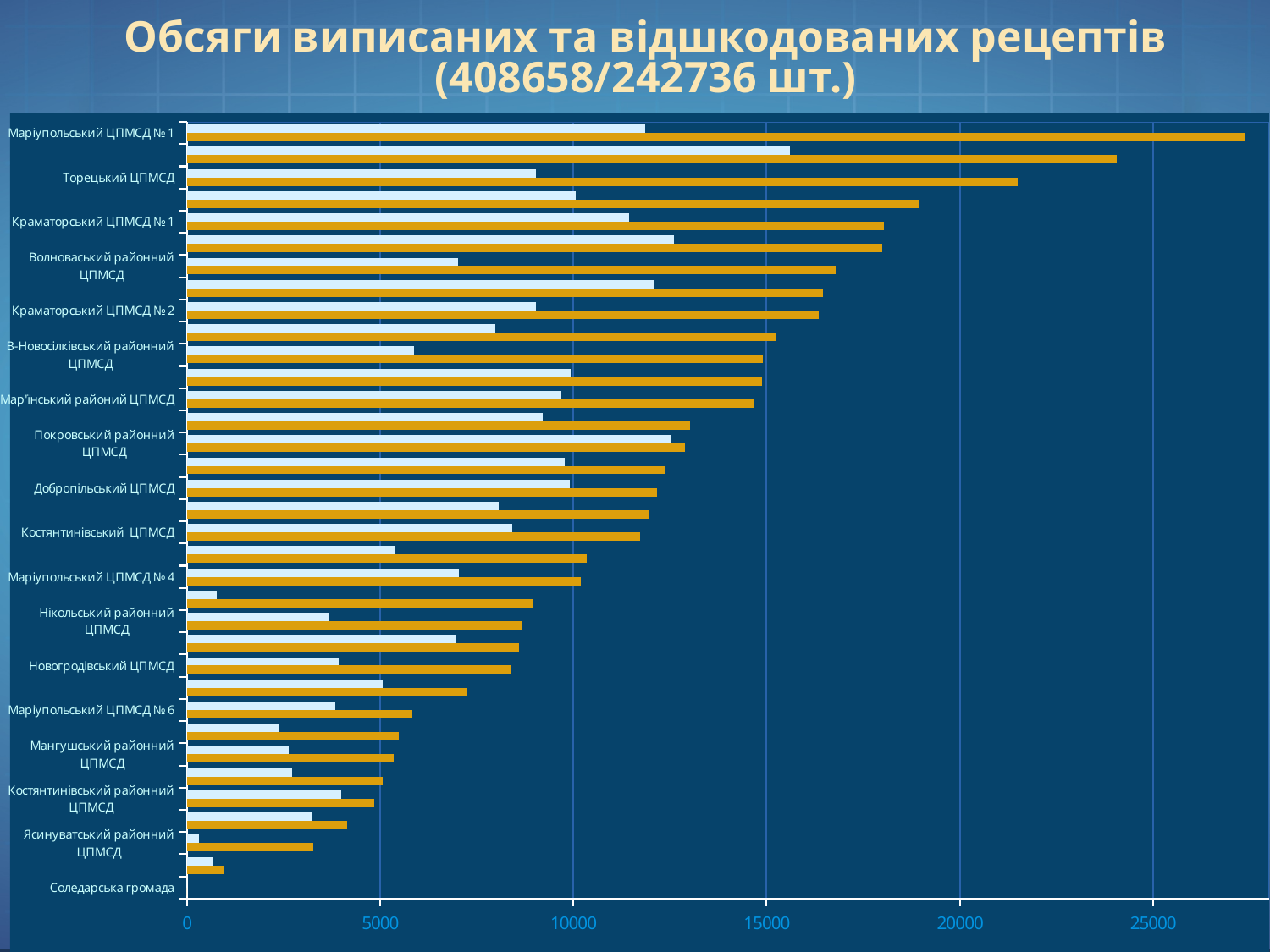
Which has the longer orange bar, Краматорський ЦПМСД № 1 or Маріупольський ЦПМСД № 6? Краматорський ЦПМСД № 1 Is the orange bar for Маріупольський ЦПМСД № 1 greater or less than 25000? greater Is the orange bar for Торецький ЦПМСД greater or less than 20000? greater Which labelled category has the shortest bars? Соледарська громада Is the orange bar for Ясинуватський районний ЦПМСД greater or less than 5000? less What two totals are given in parentheses in the chart title? 408658/242736 шт. Which category has the longest orange bar? Маріупольський ЦПМСД № 1 What kind of chart is shown on the slide? bar chart Do the orange bar values rise or fall going from the top of the chart to the bottom? fall